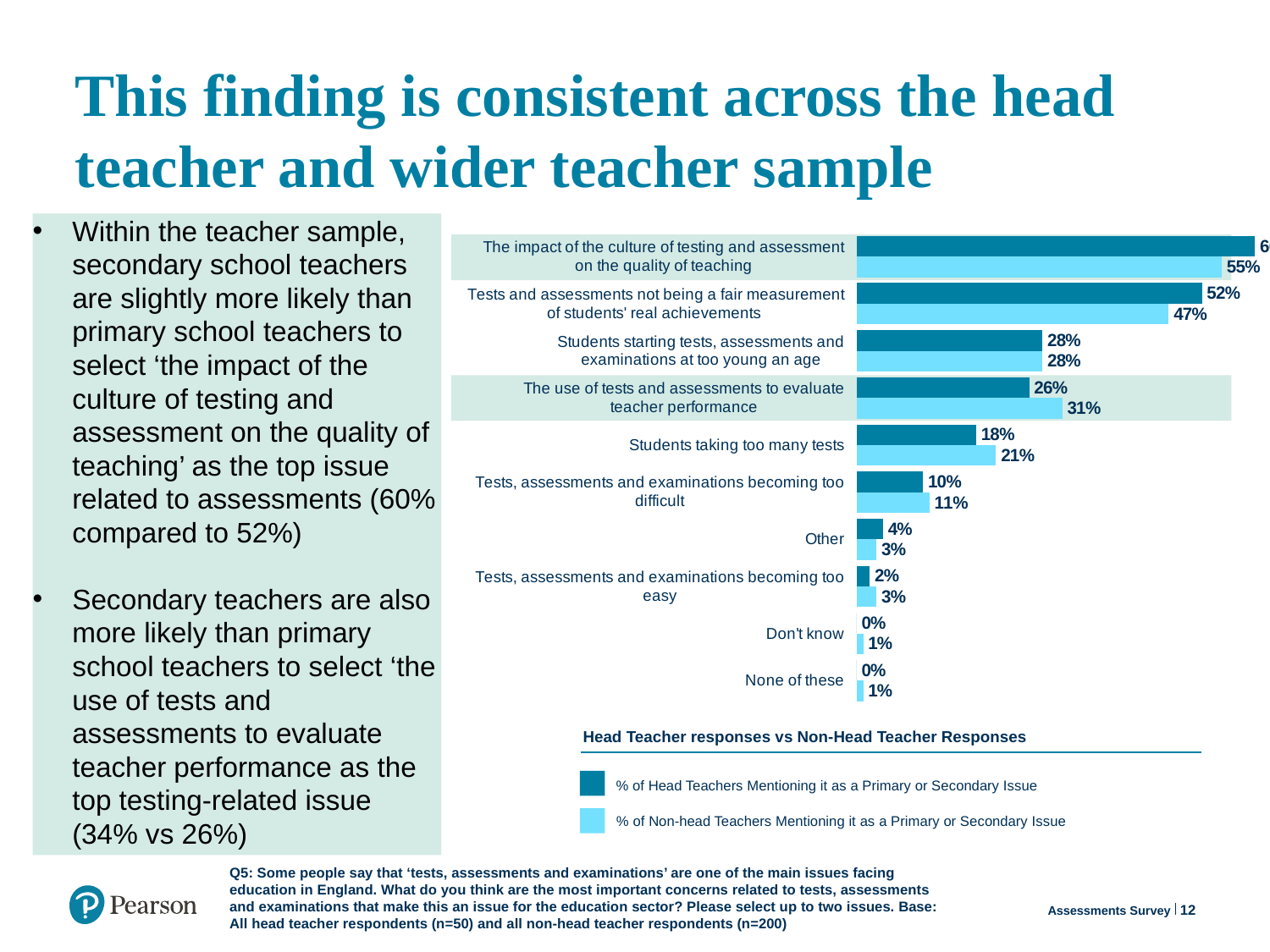
What percentage of head teachers mentioned 'Tests and assessments not being a fair measurement of students' real achievements'? 52% What kind of chart is shown on the slide? bar chart What percentage of non-head teachers mentioned 'The use of tests and assessments to evaluate teacher performance'? 31% What is the title shown beneath the chart? Head Teacher responses vs Non-Head Teacher Responses What is the difference between non-head teachers and head teachers for 'The use of tests and assessments to evaluate teacher performance'? 5% Which issue has the highest value for non-head teachers? The impact of the culture of testing and assessment on the quality of teaching What percentage of non-head teachers mentioned 'The impact of the culture of testing and assessment on the quality of teaching'? 55% How many categories (issues) are plotted on the chart? 10 What is the difference between head teachers and non-head teachers for 'Tests and assessments not being a fair measurement of students' real achievements'? 5% For 'Students taking too many tests', which group has the larger value, head teachers or non-head teachers? Non-head teachers What percentage of head teachers selected 'Don't know'? 0% How many series does the chart legend list? 2